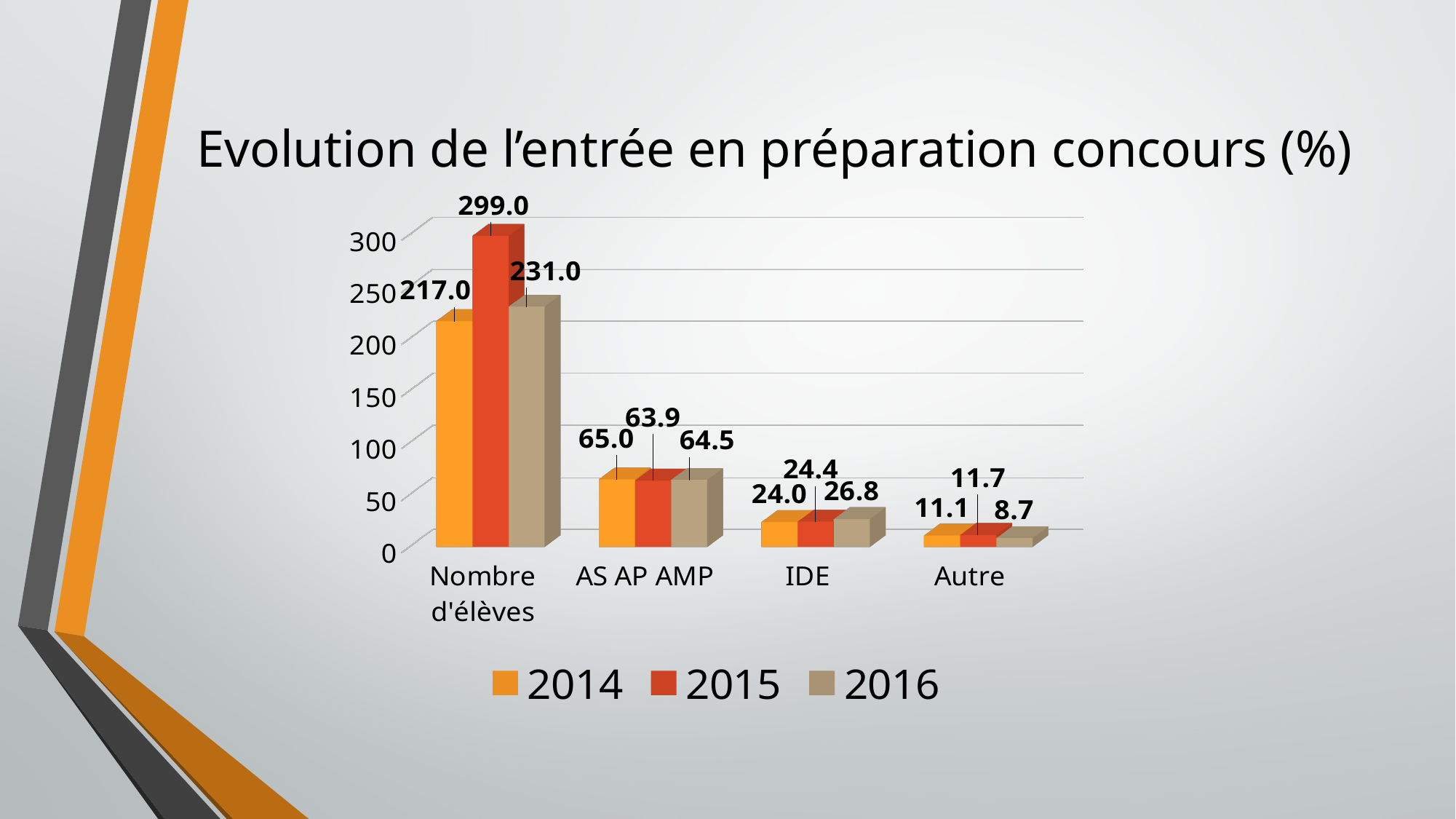
What kind of chart is shown on the slide? Bar chart What is the title of the chart? Evolution de l'entrée en préparation concours (%) Which is larger for Autre: the 2015 value or the 2016 value? 2015 What is the value for Autre in 2014? 11.1 How many categories are shown on the x axis? 4 Which category has the lowest value in 2015? Autre Which category has the highest value in 2016? Nombre d'élèves What is the value for AS AP AMP in 2015? 63.9 How many series does the legend list? 3 What is the difference between the 2015 and 2014 values for Nombre d'élèves? 82.0 What is the value for IDE in 2016? 26.8 What is the value for Nombre d'élèves in 2015? 299.0